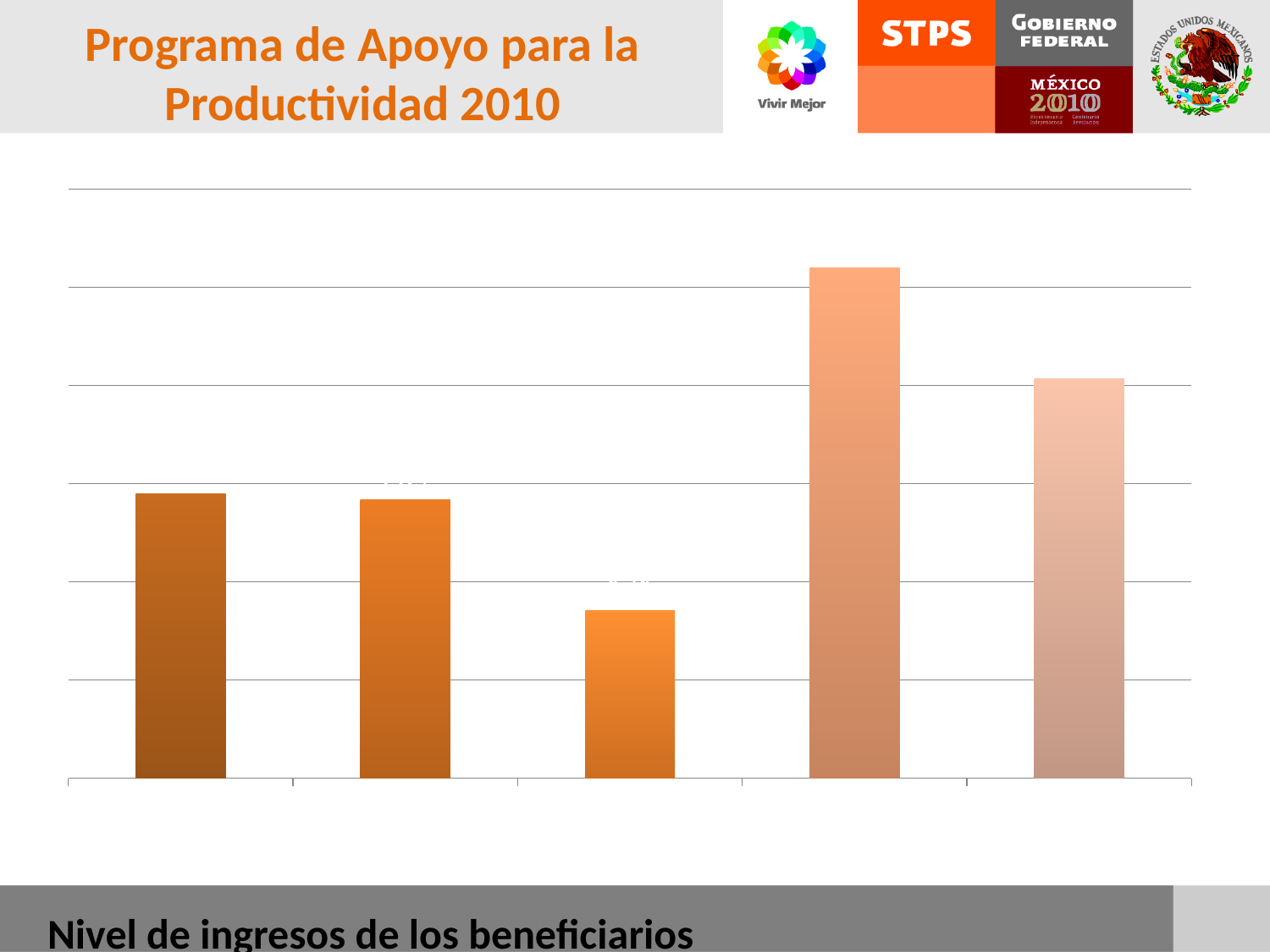
Which is taller, the first bar from the left or the third bar from the left? the first bar Which bar, counted from the left, is the tallest in the chart? the fourth bar What colour family are the bars in the chart? orange How many bars are plotted in the chart? 5 Which is taller, the fourth bar from the left or the fifth bar from the left? the fourth bar Which is taller, the fifth bar from the left or the second bar from the left? the fifth bar What caption appears below the chart describing what it shows? Nivel de ingresos de los beneficiarios Which bar, counted from the left, is the shortest in the chart? the third bar What kind of chart is shown on the slide? bar chart